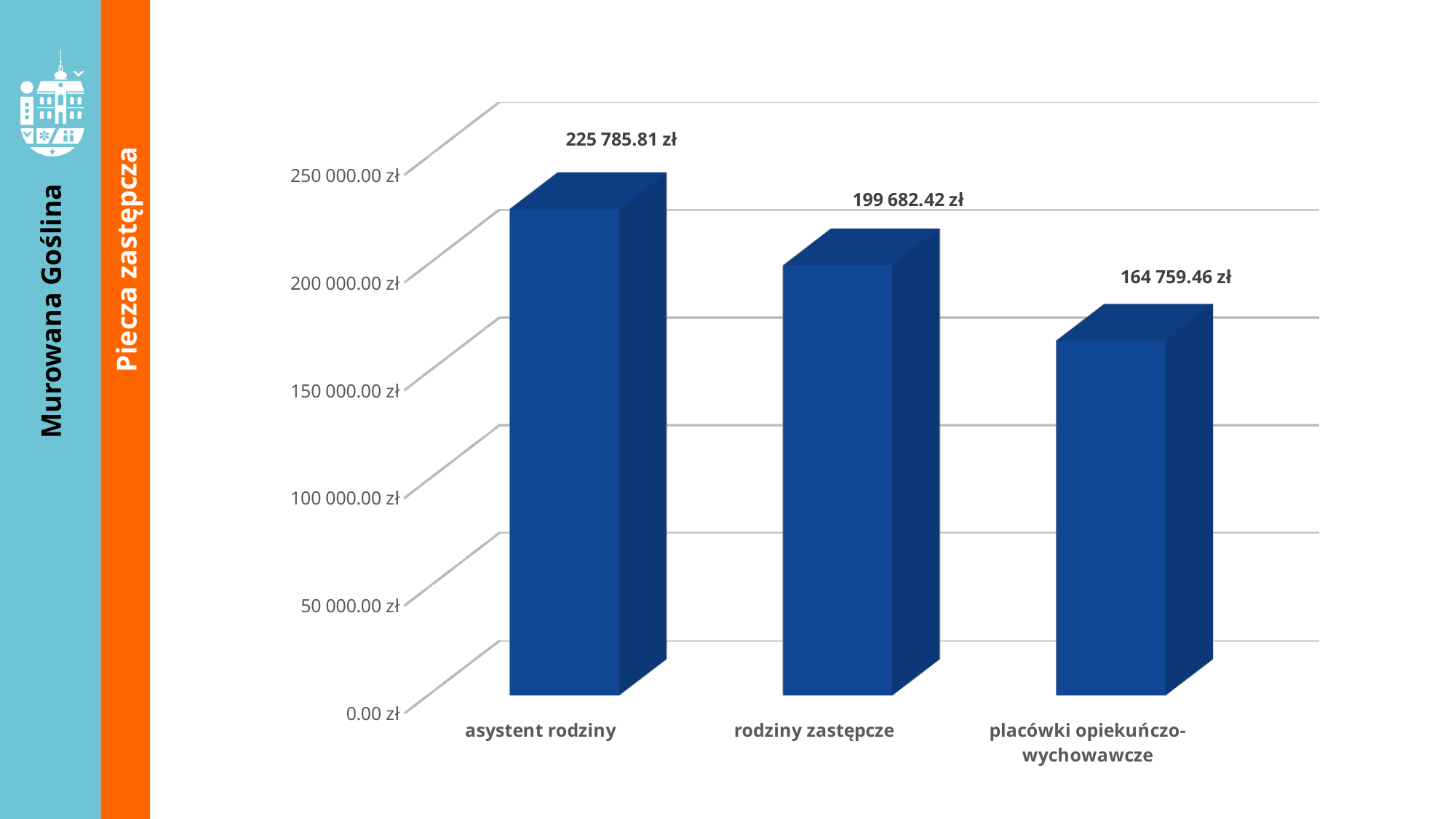
Do the values rise or fall from left to right across the categories? fall How many categories are shown on the chart? 3 Which category has the highest value? asystent rodziny What is the value for rodziny zastępcze? 199 682.42 zł Which category has the lowest value? placówki opiekuńczo-wychowawcze What is the value for placówki opiekuńczo-wychowawcze? 164 759.46 zł What kind of chart is shown on the slide? bar chart Which is larger, the value for rodziny zastępcze or the value for placówki opiekuńczo-wychowawcze? rodziny zastępcze What is the value for asystent rodziny? 225 785.81 zł What is the difference between the values for asystent rodziny and rodziny zastępcze? 26 103.39 zł What is the difference between the values for rodziny zastępcze and placówki opiekuńczo-wychowawcze? 34 922.96 zł Is the value for placówki opiekuńczo-wychowawcze greater or less than 150 000.00 zł? greater